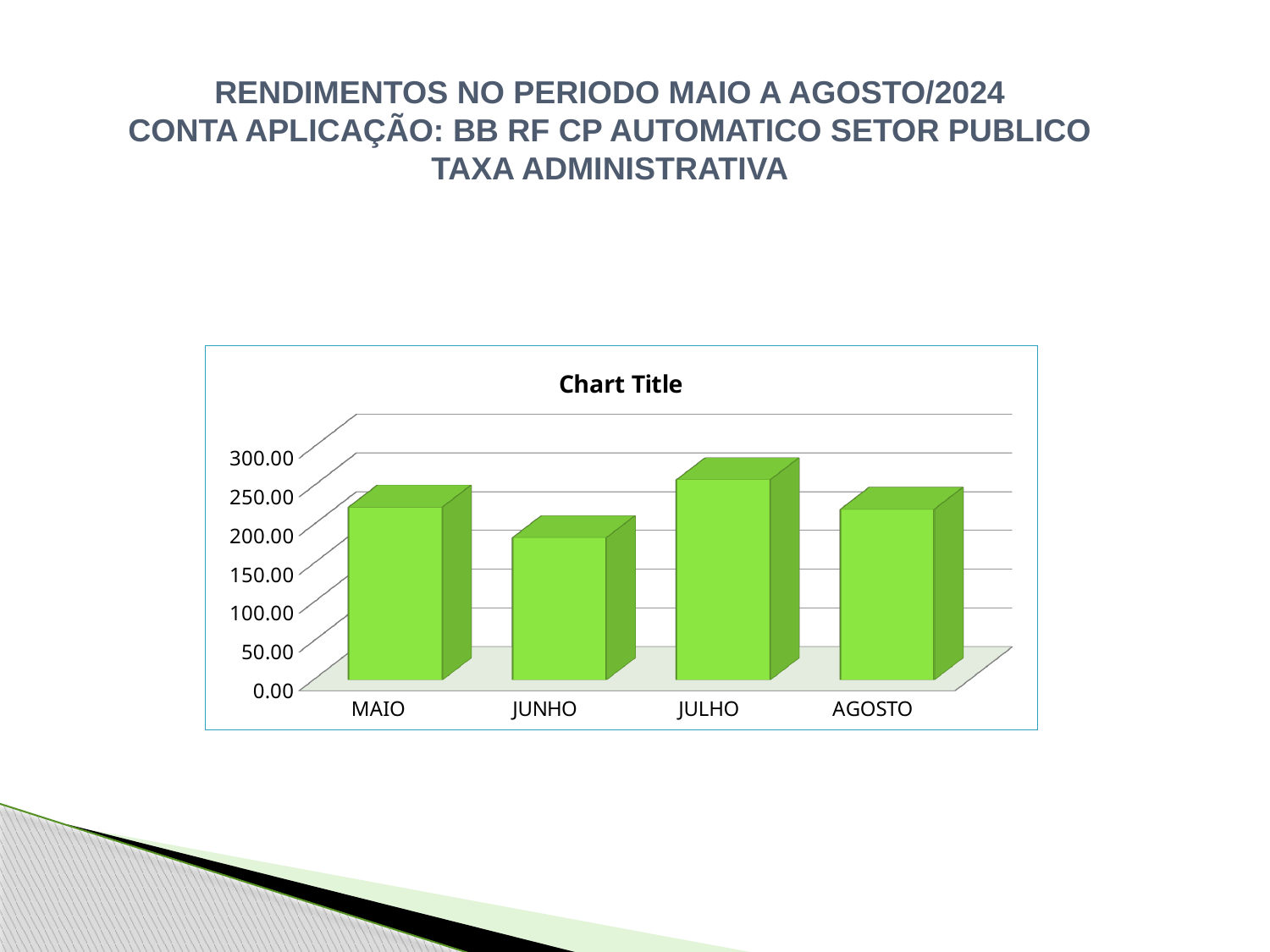
Which is larger, the value for JULHO or the value for JUNHO? JULHO Which is larger, the value for MAIO or the value for JUNHO? MAIO Does the value rise or fall from JUNHO to JULHO? rise What title is printed above the plot area of the chart? Chart Title Is the value for JULHO greater or less than 200? greater Is the value for MAIO greater or less than 300? less How many categories are plotted on the x axis of the chart? 4 Is the value for JUNHO greater or less than 150? greater Which month has the highest value in the chart? JULHO Which month has the lowest value in the chart? JUNHO What kind of chart is shown on the slide? bar chart